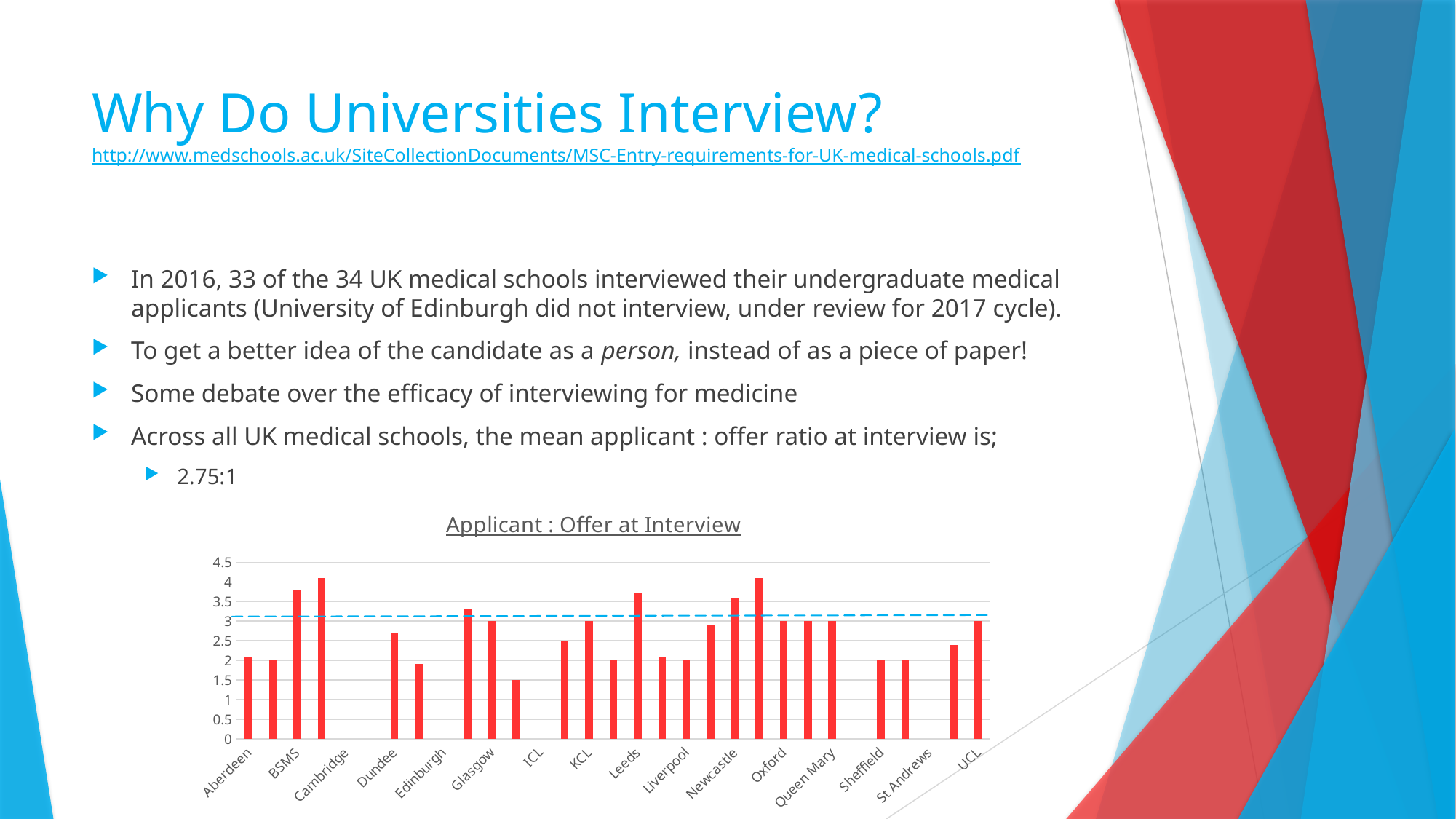
Is the value for Dundee greater or less than 3? less What colour are the bars in the chart? red Is the value for Sheffield greater or less than 3? less Is the value for Aberdeen greater or less than 3? less Which is larger, the value for Leeds or the value for Liverpool? Leeds Which is larger, the value for BSMS or the value for Dundee? BSMS What kind of chart is shown on the slide? bar chart How many university labels are shown on the x axis of the chart? 16 What is the title of the chart? Applicant : Offer at Interview